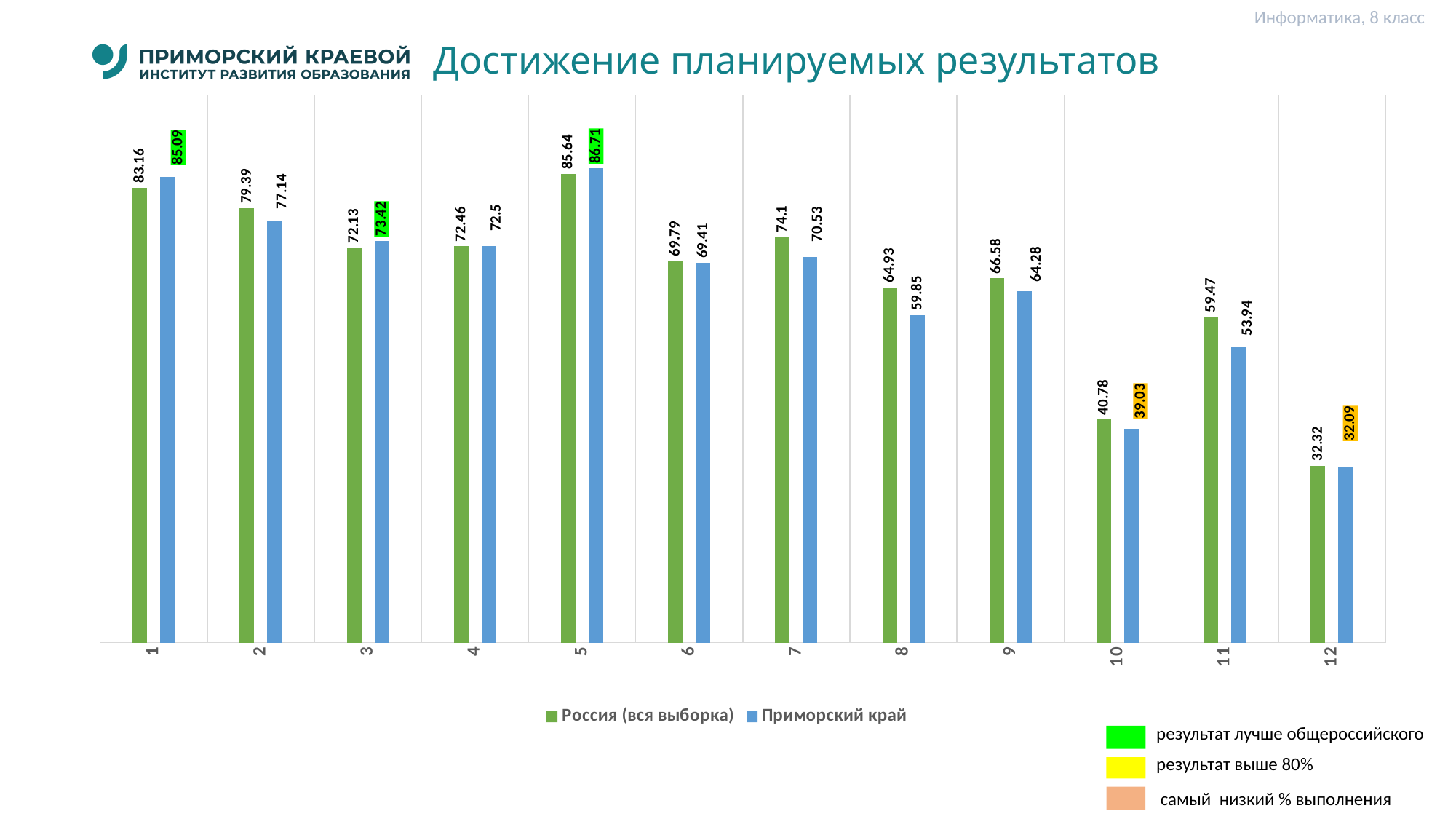
What is the value for Приморский край in category 5? 86.71 What is the difference between Приморский край and Россия (вся выборка) in category 1? 1.93 What is the title of the chart? Достижение планируемых результатов What is the value for Приморский край in category 10? 39.03 How many categories are shown on the x axis? 12 What is the value for Россия (вся выборка) in category 8? 64.93 In category 7, which series has the larger value, Россия (вся выборка) or Приморский край? Россия (вся выборка) Which category has the lowest value for Россия (вся выборка)? 12 Which category has the highest value for Приморский край? 5 What type of chart is shown on the slide? Bar chart What is the difference between Россия (вся выборка) and Приморский край in category 11? 5.53 How many series does the legend list? 2